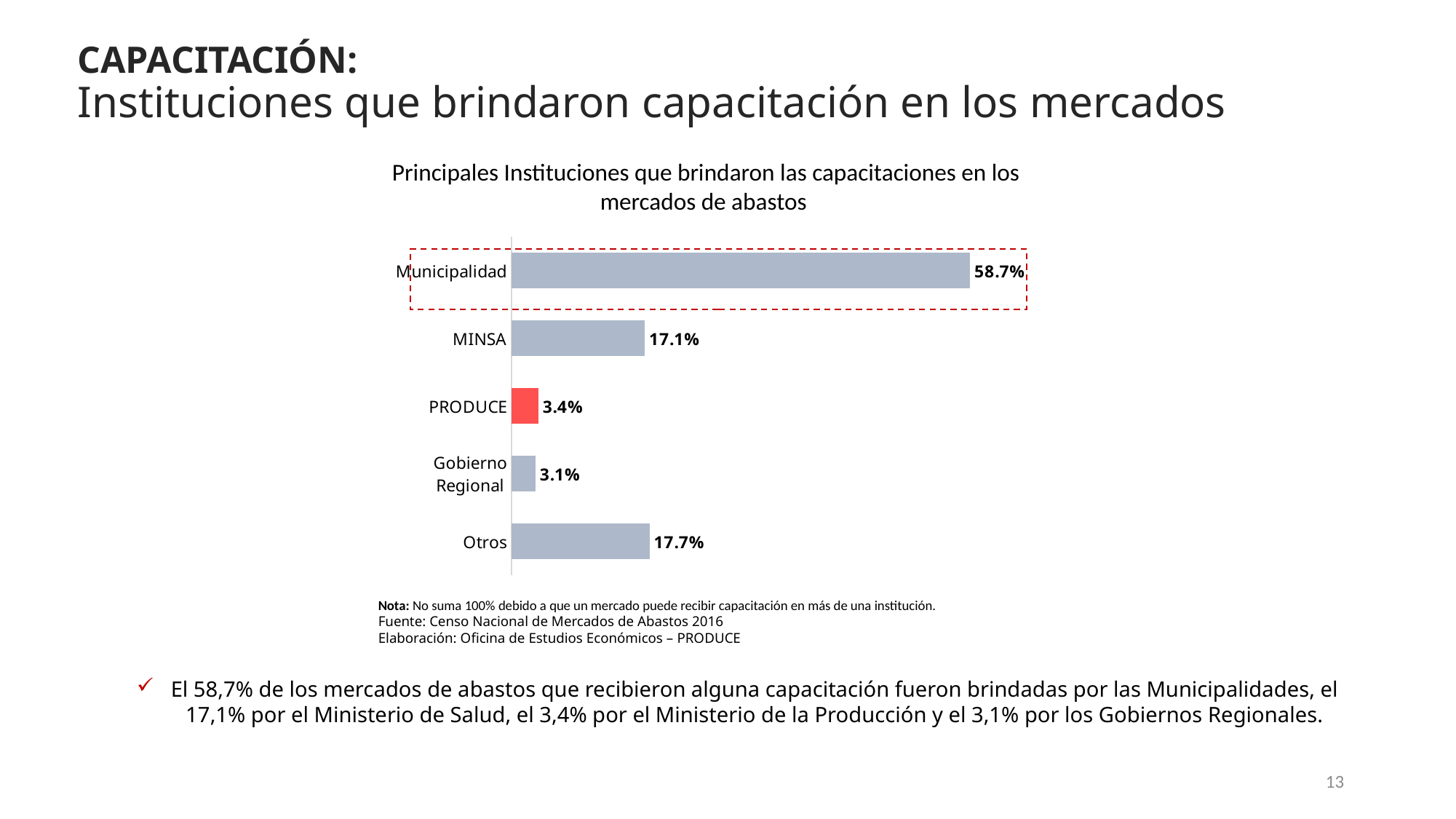
What is the value for Municipalidad? 58.7% What is the difference between the values for Municipalidad and MINSA? 41.6% Which is larger, the value for Otros or the value for MINSA? Otros What is the value for PRODUCE? 3.4% What is the value for Otros? 17.7% What type of chart is shown? Bar chart What is the value for MINSA? 17.1% What is the value for Gobierno Regional? 3.1% What is the difference between the values for PRODUCE and Gobierno Regional? 0.3% Which institution has the lowest value? Gobierno Regional Which institution has the highest value? Municipalidad How many institutions are shown in the chart? 5